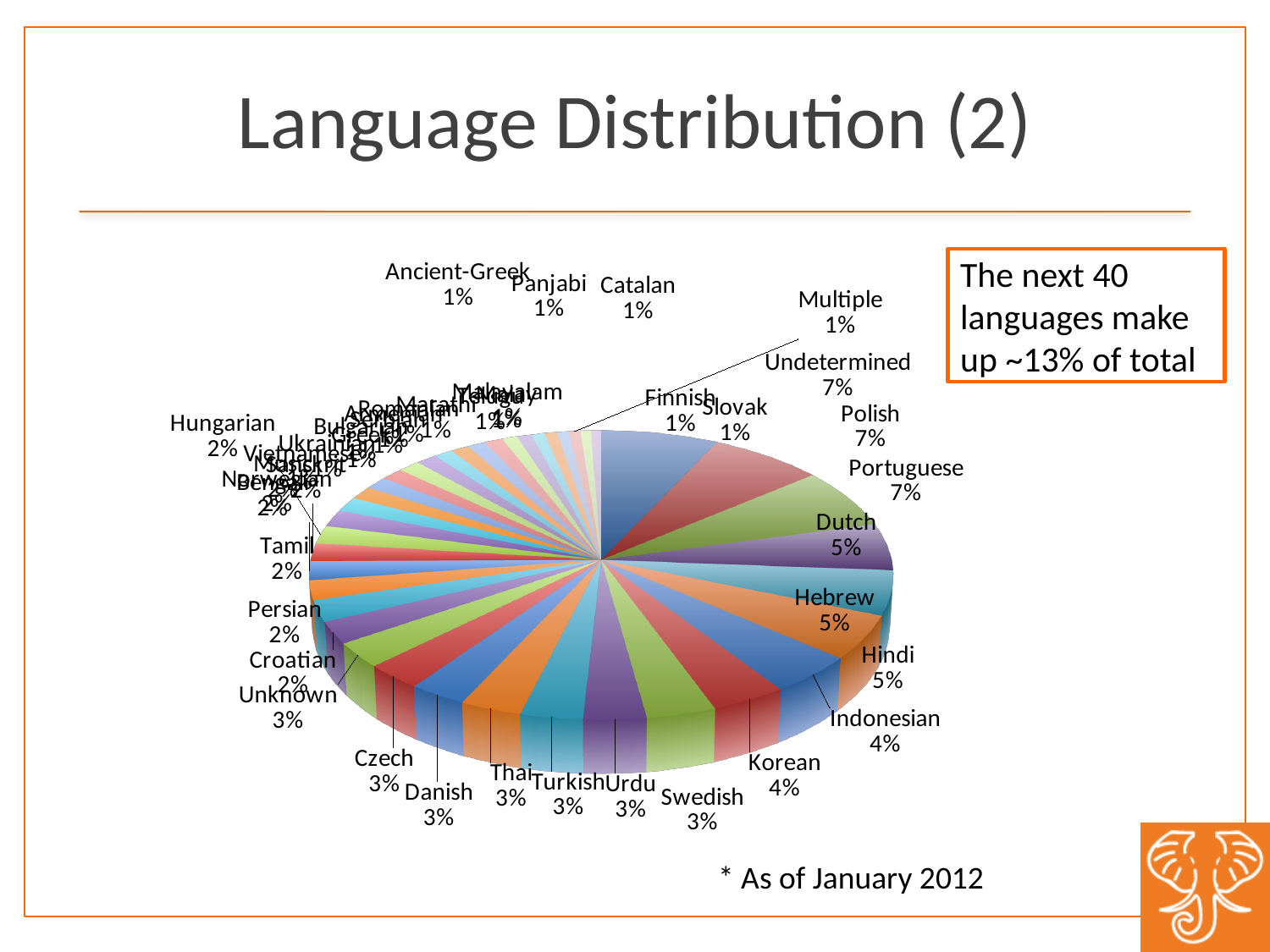
What type of chart is shown on the slide? pie chart What share of the pie does Dutch have? 5% What is the title of the slide containing the chart? Language Distribution (2) What is the value shown for Indonesian? 4% Which has the larger share, Hebrew or Swedish? Hebrew What is the value shown for Korean? 4% Which has the larger share, Polish or Hindi? Polish What is the value shown for Tamil? 2% What is the value shown for Czech? 3% What is the value shown for Catalan? 1% What is the difference in percentage points between Undetermined and Persian? 5 What share of the pie does Portuguese have? 7%